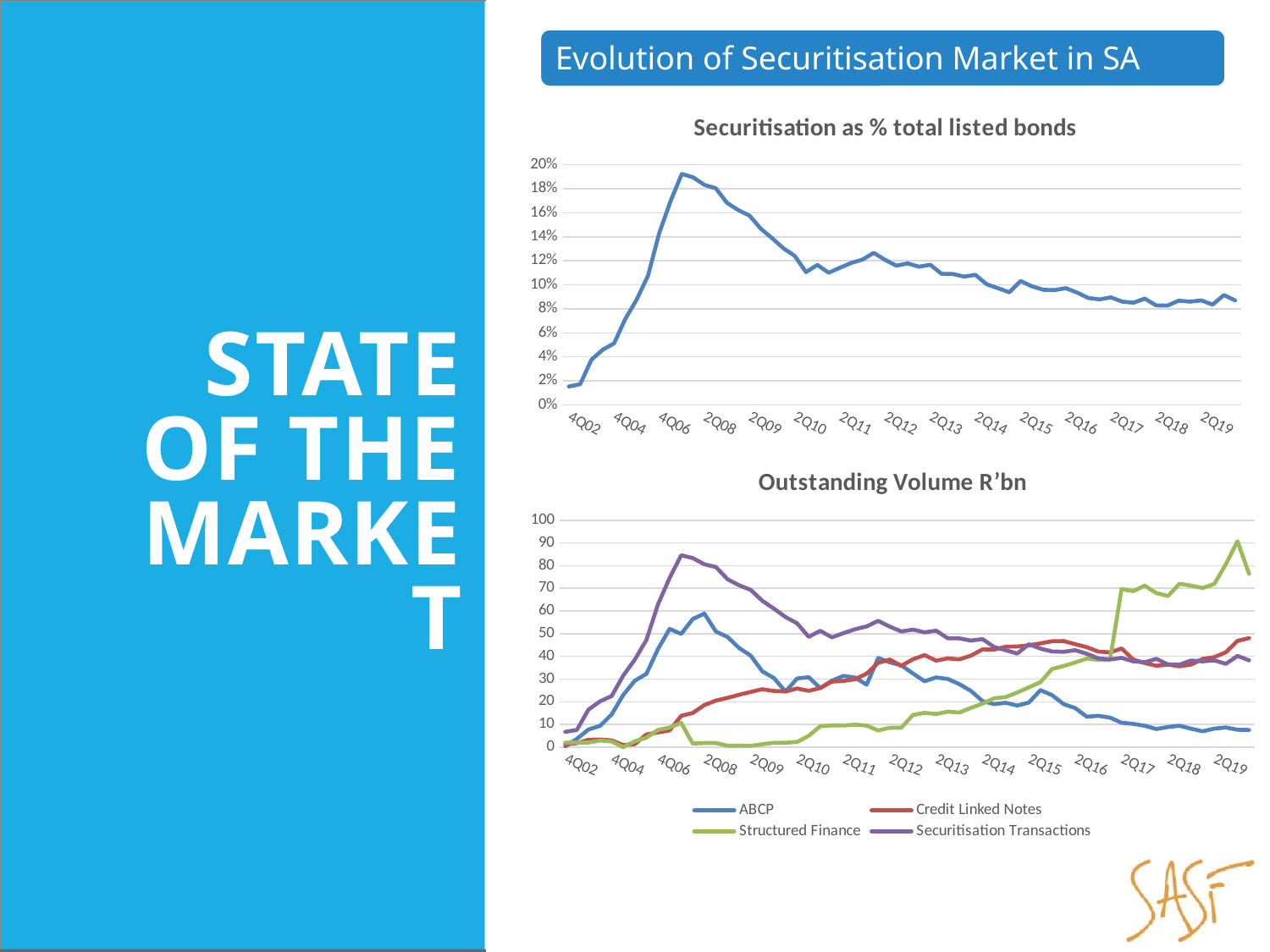
In the 'Securitisation as % total listed bonds' chart, is the value at 2Q19 greater or less than 10%? less In the 'Securitisation as % total listed bonds' chart, is the value at 4Q02 greater or less than 4%? less In the 'Outstanding Volume R'bn' chart, what colour is the Structured Finance line? green In the 'Securitisation as % total listed bonds' chart, is the value at 4Q06 greater or less than 18%? less How many series does the legend of the 'Outstanding Volume R'bn' chart list? 4 In the 'Outstanding Volume R'bn' chart, which series has the highest value at 2Q19? Structured Finance In the 'Outstanding Volume R'bn' chart, which series has the highest value at 4Q06? Securitisation Transactions In the 'Outstanding Volume R'bn' chart, which is larger at 2Q19: ABCP or Credit Linked Notes? Credit Linked Notes What kind of chart is the 'Securitisation as % total listed bonds' chart? line chart In the 'Securitisation as % total listed bonds' chart, does the line rise or fall between 2Q08 and 2Q19? fall